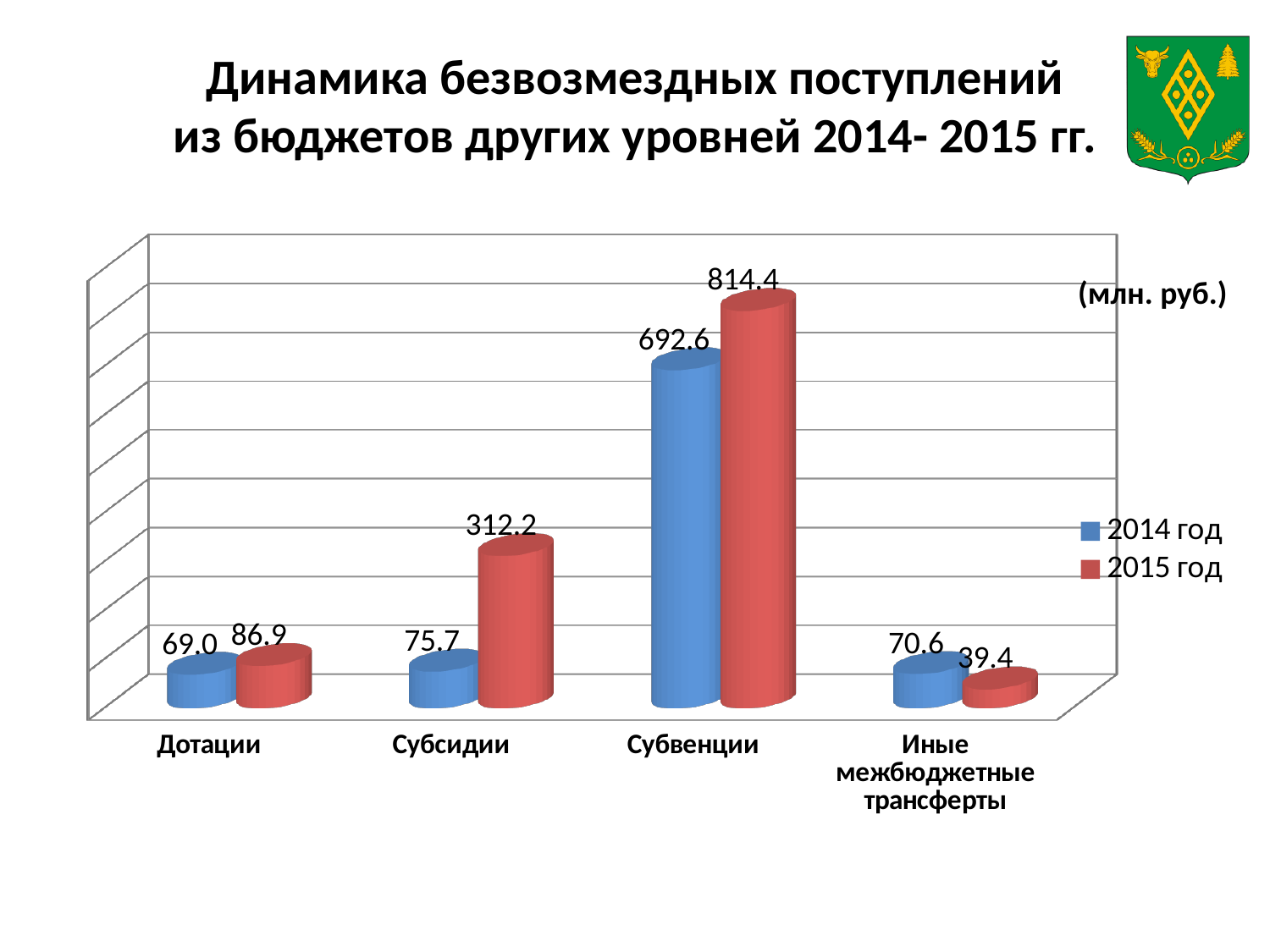
Which category has the lowest value in 2015 год? Иные межбюджетные трансферты What is the difference between the 2015 год and 2014 год values for Субсидии? 236.5 What is the difference between the 2015 год and 2014 год values for Субвенции? 121.8 How many categories are shown on the x axis? 4 What is the value for Дотации in 2014 год? 69.0 What is the value for Субсидии in 2014 год? 75.7 What is the value for Субвенции in 2015 год? 814.4 For Иные межбюджетные трансферты, which year has the larger value, 2014 год or 2015 год? 2014 год What kind of chart is shown on the slide? Bar chart What is the value for Иные межбюджетные трансферты in 2015 год? 39.4 How many series does the legend list? 2 Which category has the highest value in 2015 год? Субвенции